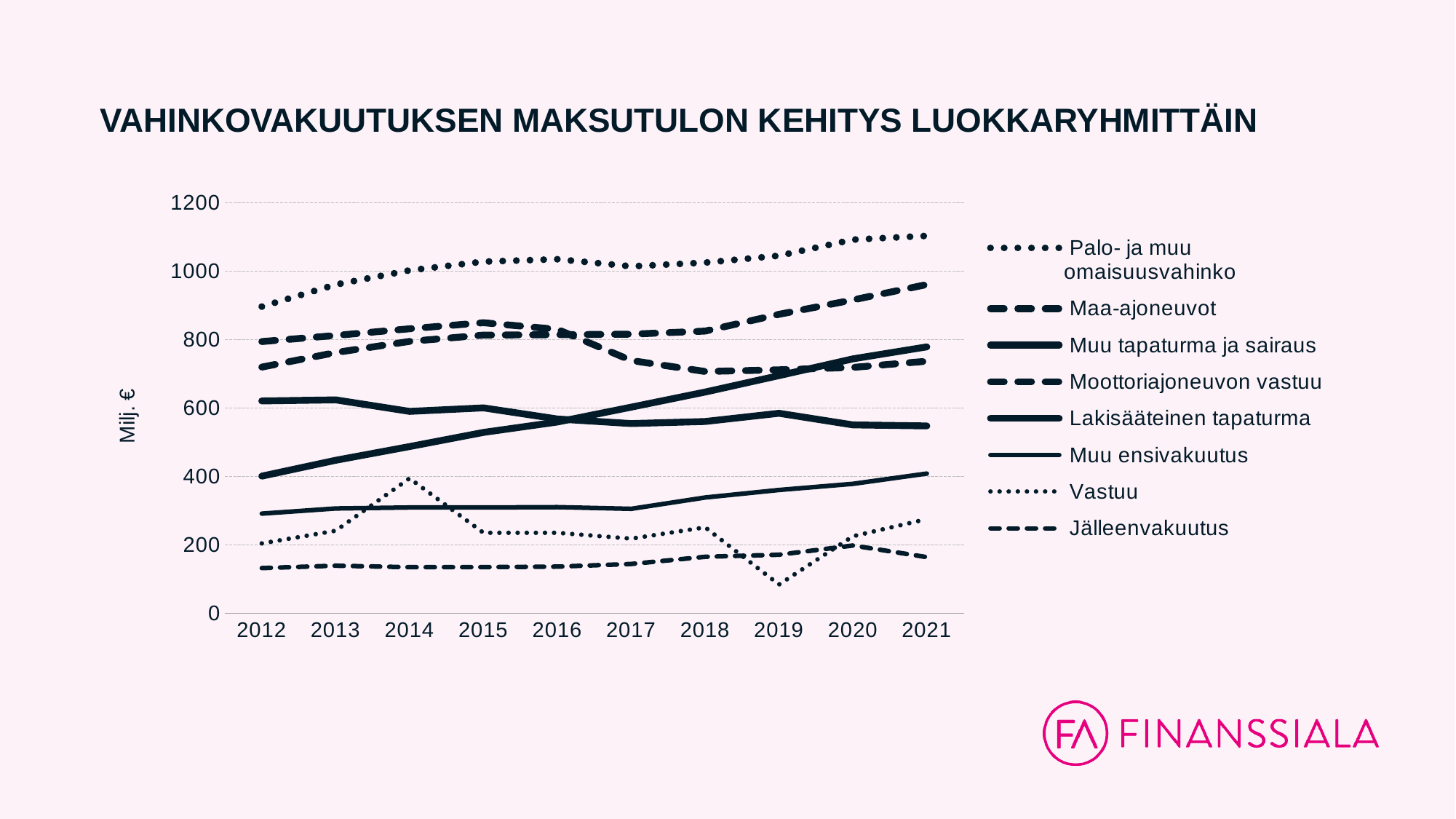
Does the Muu tapaturma ja sairaus series rise or fall from 2012 to 2021? rise Is the value for Palo- ja muu omaisuusvahinko in 2012 greater or less than 1000? less Is the value for Muu tapaturma ja sairaus in 2021 greater or less than 600? greater In 2021, which is larger: Maa-ajoneuvot or Moottoriajoneuvon vastuu? Maa-ajoneuvot Which series has the highest value in 2021? Palo- ja muu omaisuusvahinko What is the label on the y axis? Milj. € Which series has the lowest value in 2021? Jälleenvakuutus How many years are shown on the x axis? 10 What kind of chart is shown on the slide? line chart How many series does the legend list? 8 In which year does the Vastuu series reach its lowest value? 2019 Is the value for Jälleenvakuutus in 2012 greater or less than 200? less